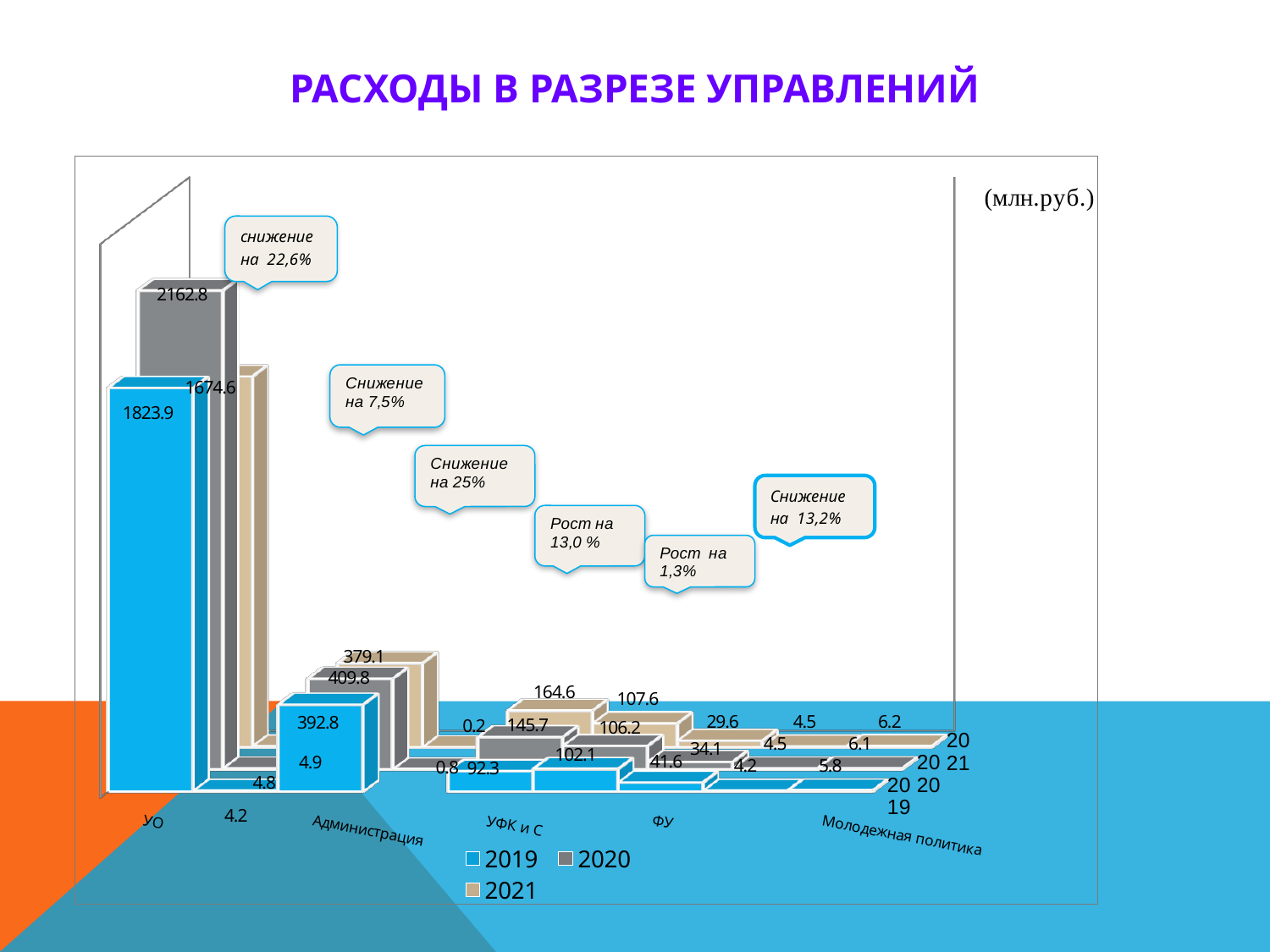
What is the 2019 value for УО? 1823.9 How many series does the legend list? 3 What is the difference between the 2020 and 2019 values for УО? 338.9 For Администрация, which is larger: the 2020 value or the 2021 value? 2020 What is the 2021 value for ФУ? 29.6 What is the difference between the 2021 and 2020 values for УФК и С? 18.9 Which category has the highest 2020 value? УО What is the 2021 value for Администрация? 379.1 What unit is indicated for the values on the chart? млн.руб. What kind of chart is shown on the slide? bar chart What is the 2020 value for УФК и С? 145.7 What is the 2020 value for УО? 2162.8